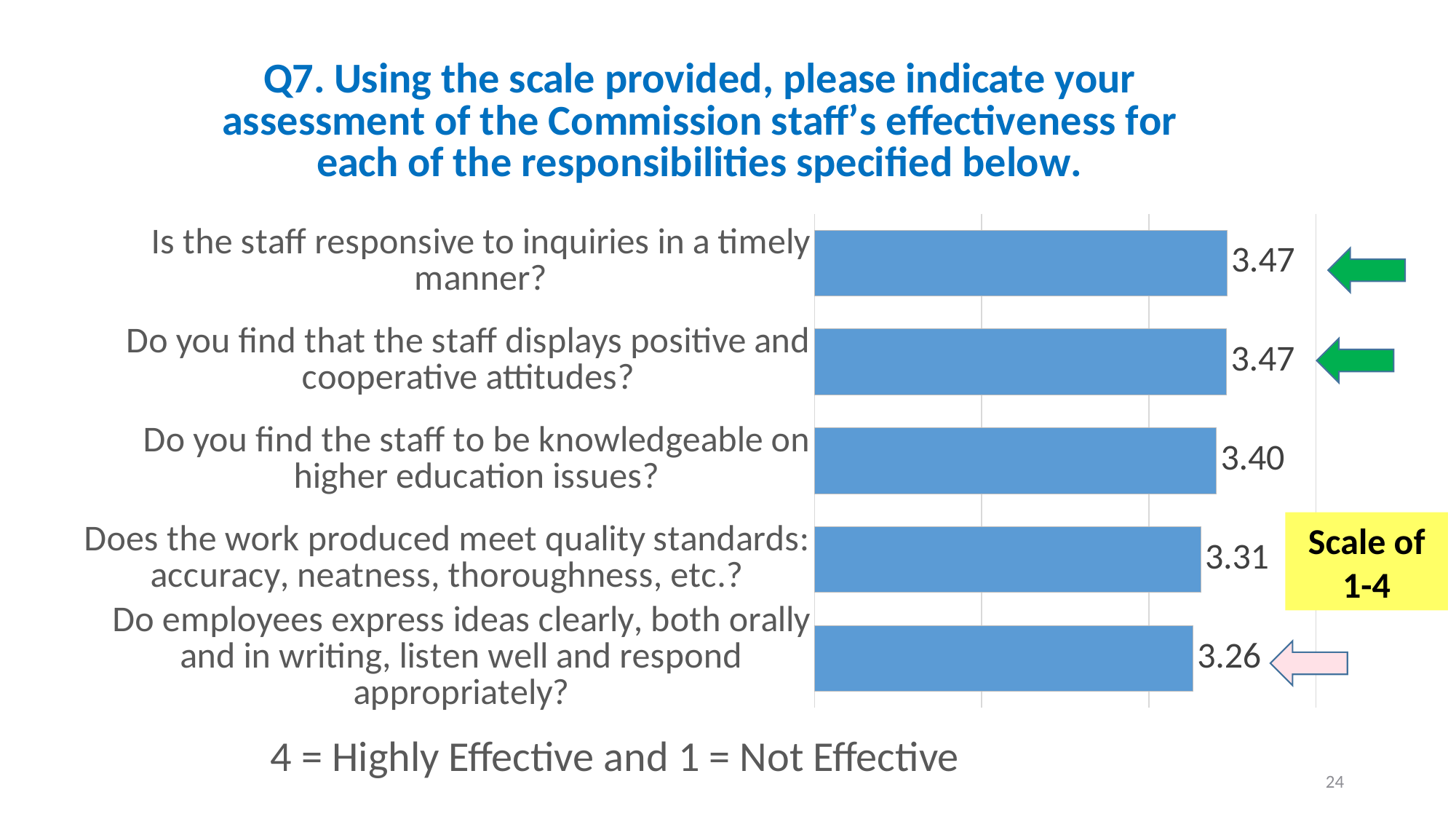
Which is larger: the value for "Do you find the staff to be knowledgeable on higher education issues?" or the value for "Does the work produced meet quality standards: accuracy, neatness, thoroughness, etc.?" Do you find the staff to be knowledgeable on higher education issues? What is the value for "Is the staff responsive to inquiries in a timely manner?" 3.47 What is the highest value shown in the chart? 3.47 What rating scale is used for the values in the chart? Scale of 1-4 What is the value for "Do employees express ideas clearly, both orally and in writing, listen well and respond appropriately?" 3.26 What is the value for "Does the work produced meet quality standards: accuracy, neatness, thoroughness, etc.?" 3.31 What is the value for "Do you find the staff to be knowledgeable on higher education issues?" 3.40 What kind of chart is shown on the slide? Bar chart What is the difference between the value for "Do you find the staff to be knowledgeable on higher education issues?" and the value for "Does the work produced meet quality standards: accuracy, neatness, thoroughness, etc.?" 0.09 Which category has the lowest value? Do employees express ideas clearly, both orally and in writing, listen well and respond appropriately? How many categories are shown in the chart? 5 What is the difference between the value for "Is the staff responsive to inquiries in a timely manner?" and the value for "Do employees express ideas clearly, both orally and in writing, listen well and respond appropriately?" 0.21